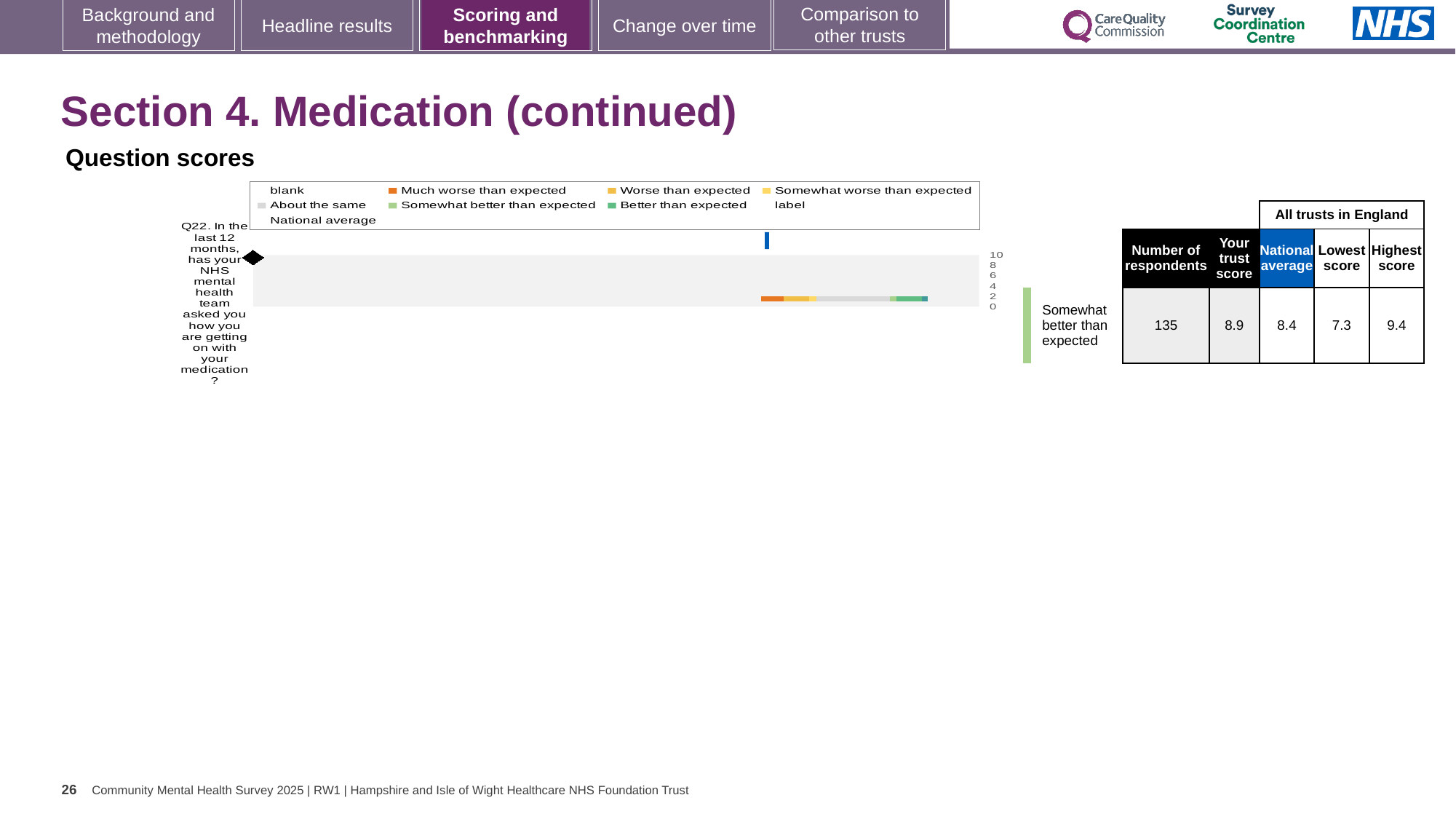
For Q22, which is larger: the trust's score or the national average? the trust's score For Q22, how much higher is the trust's score than the national average? 0.5 In the table beside the chart, what is the lowest score among all trusts in England for Q22? 7.3 How many survey questions are plotted on the chart? 1 In the table beside the chart, what is the highest score among all trusts in England for Q22? 9.4 In the table beside the chart, what is the trust's score for Q22? 8.9 For Q22, what is the difference between the highest and lowest scores among all trusts in England? 2.1 What kind of chart is used to show the Q22 question score? bar chart In the table beside the chart, what is the number of respondents for Q22? 135 Which benchmark category is shown for Q22 next to the chart? Somewhat better than expected What colour does the legend use for 'Much worse than expected'? orange In the table beside the chart, what is the national average score for Q22? 8.4